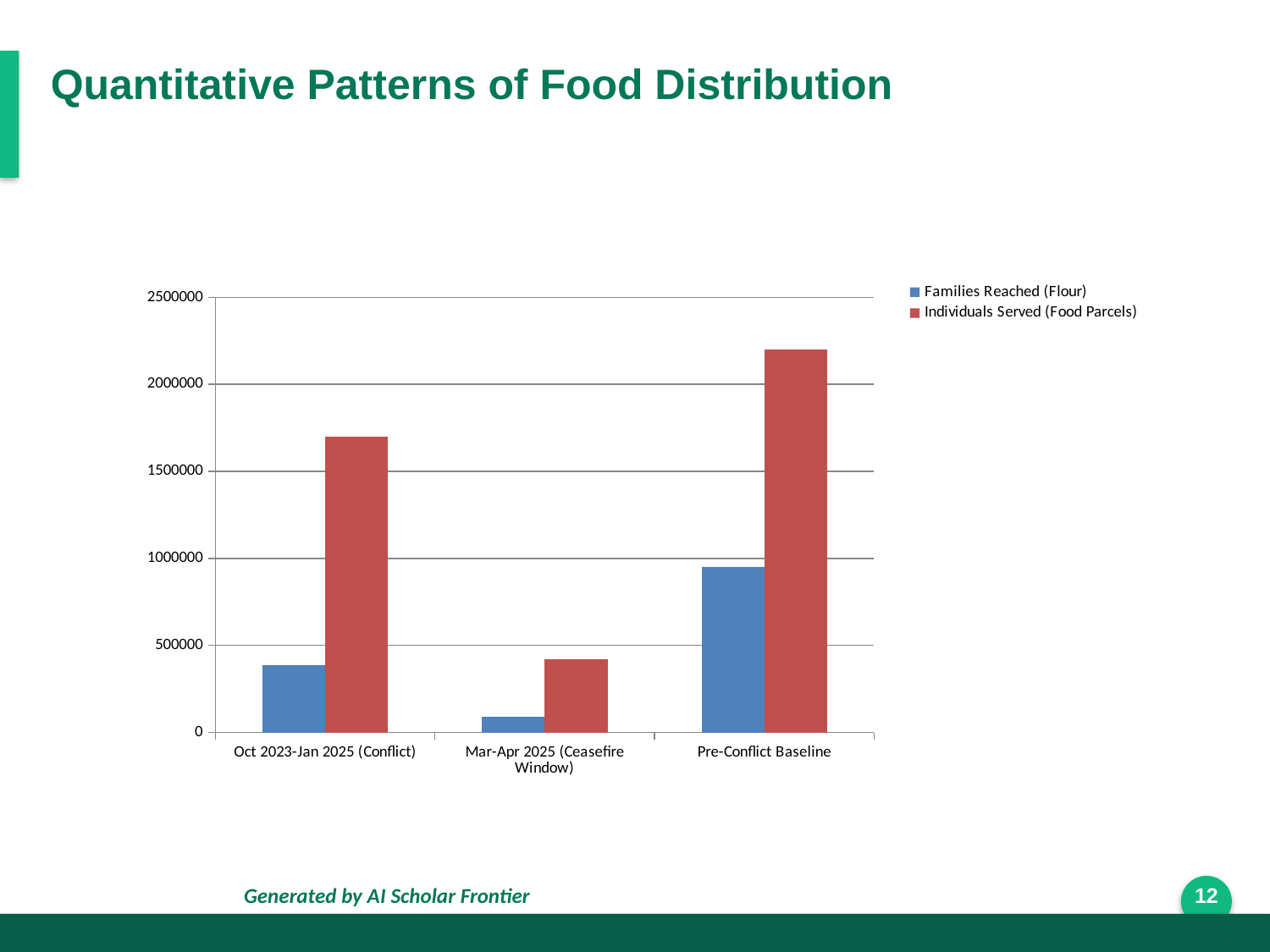
Is the value for Individuals Served (Food Parcels) in Pre-Conflict Baseline greater or less than 2000000? greater Which category has the lowest value for Families Reached (Flour)? Mar-Apr 2025 (Ceasefire Window) Is the value for Individuals Served (Food Parcels) in Oct 2023-Jan 2025 (Conflict) greater or less than 1500000? greater Which category has the lowest value for Individuals Served (Food Parcels)? Mar-Apr 2025 (Ceasefire Window) How many categories are shown on the x axis? 3 Which series is shown in red? Individuals Served (Food Parcels) How many series does the legend list? 2 Which category has the highest value for Individuals Served (Food Parcels)? Pre-Conflict Baseline Which is larger: Families Reached (Flour) in Pre-Conflict Baseline or Families Reached (Flour) in Oct 2023-Jan 2025 (Conflict)? Pre-Conflict Baseline Is the value for Families Reached (Flour) in Oct 2023-Jan 2025 (Conflict) greater or less than 500000? less What is the title of the slide containing the chart? Quantitative Patterns of Food Distribution What kind of chart is shown on the slide? bar chart